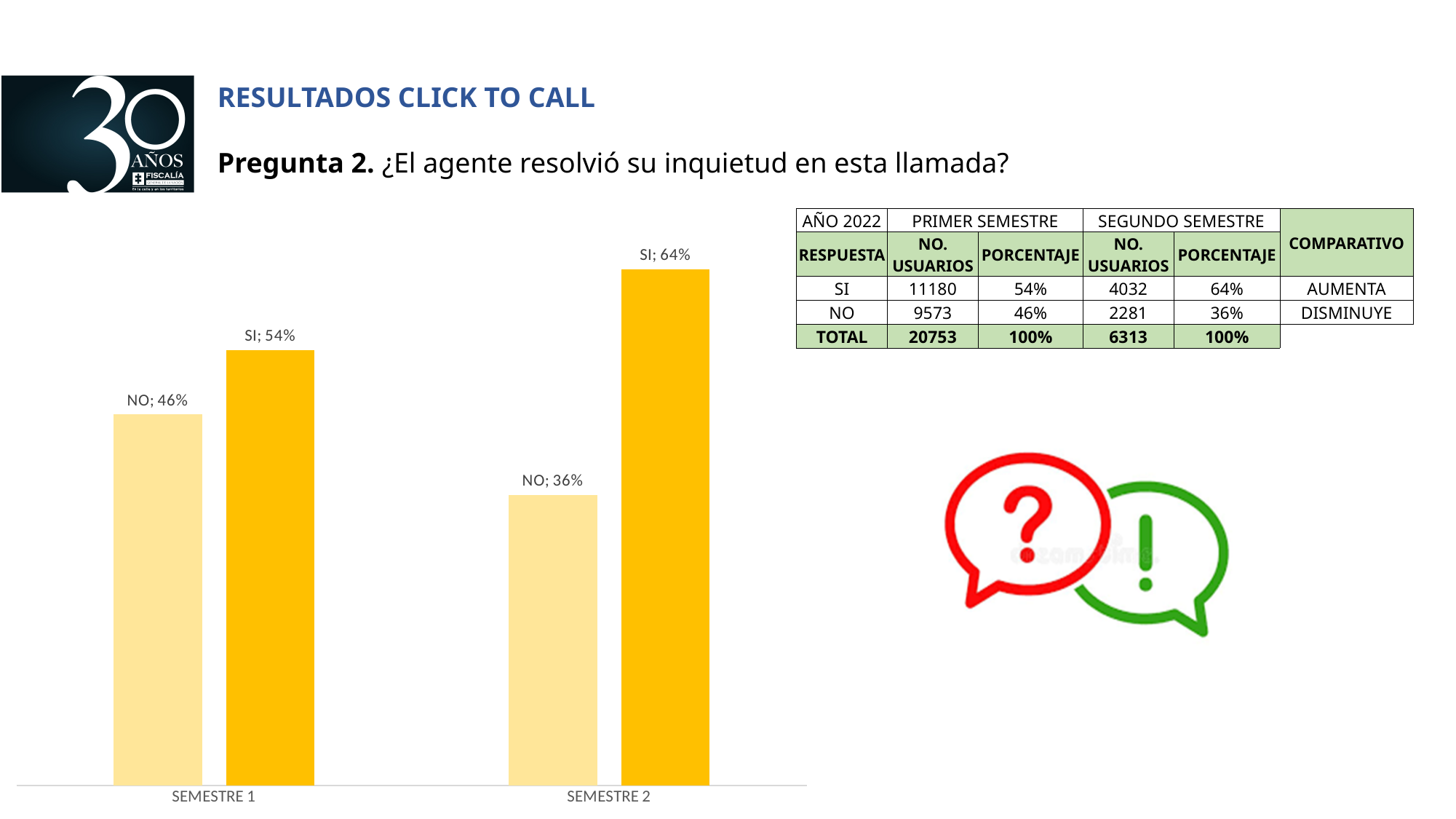
Which bar has the highest value in the chart? SI in SEMESTRE 2 What is the value for SI in SEMESTRE 1? 54% What is the difference between the SI values for SEMESTRE 2 and SEMESTRE 1? 10% What is the value for SI in SEMESTRE 2? 64% Which bar has the lowest value in the chart? NO in SEMESTRE 2 Does the SI value rise or fall from SEMESTRE 1 to SEMESTRE 2? Rise What is the value for NO in SEMESTRE 1? 46% How many categories are shown on the x axis of the chart? 2 What is the difference between SI and NO in SEMESTRE 2? 28% What is the value for NO in SEMESTRE 2? 36% What kind of chart is shown on the slide? Bar chart Which is larger in SEMESTRE 1, SI or NO? SI